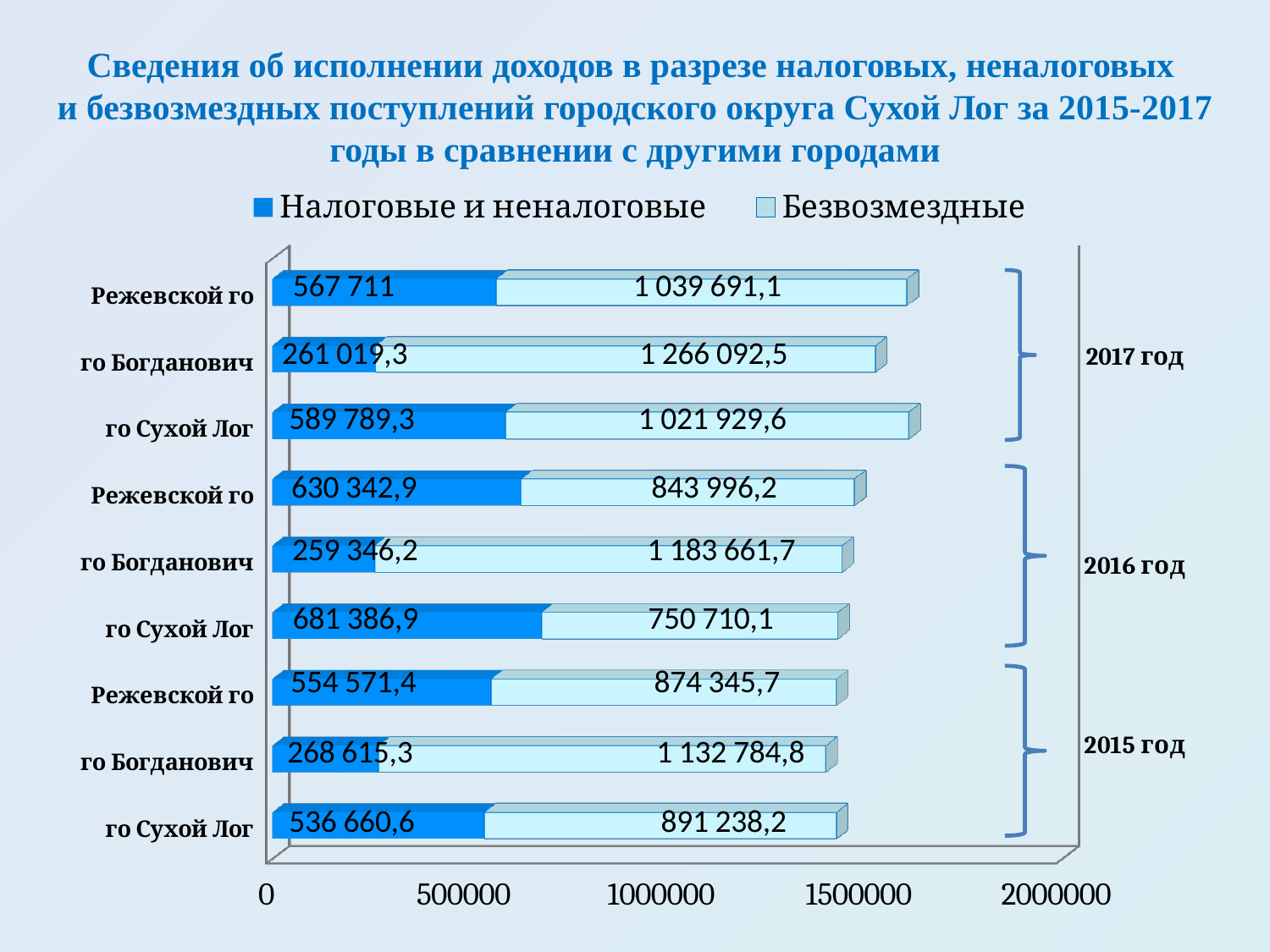
Which is larger in 2016 год: the Налоговые и неналоговые value for Режевской го or for го Сухой Лог? го Сухой Лог How many bars are plotted on the chart? 9 Which bar has the highest Налоговые и неналоговые value? го Сухой Лог, 2016 год What is the value of Безвозмездные for го Богданович in 2016 год? 1 183 661,7 What kind of chart is shown on the slide? Stacked bar chart What is the value of Налоговые и неналоговые for го Сухой Лог in 2017 год? 589 789,3 How many series does the legend list? 2 Which bar has the highest Безвозмездные value? го Богданович, 2017 год What is the difference between the Налоговые и неналоговые values for го Сухой Лог in 2016 год and 2017 год? 91 597,6 What is the value of Безвозмездные for Режевской го in 2015 год? 874 345,7 What is the total of the stacked bar for го Сухой Лог in 2017 год? 1 611 718,9 What is the value of Налоговые и неналоговые for го Богданович in 2015 год? 268 615,3